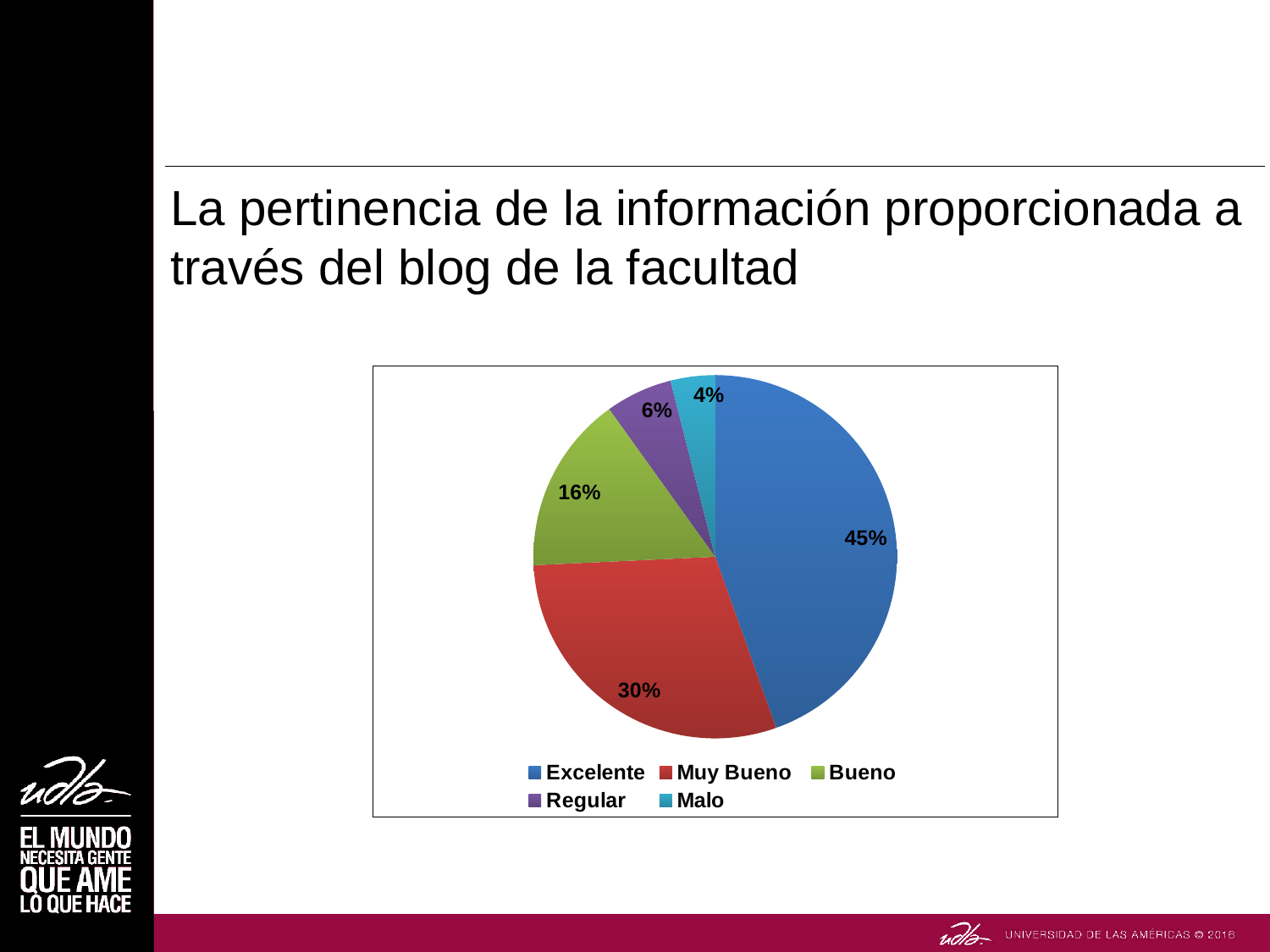
What percentage of the pie chart is labelled Excelente? 45% What percentage of the pie chart is labelled Malo? 4% How many categories does the pie chart show? 5 Which category has the smallest share of the pie chart? Malo What percentage of the pie chart is labelled Regular? 6% Which is larger, the share for Bueno or the share for Regular? Bueno What percentage of the pie chart is labelled Muy Bueno? 30% Which category has the largest share of the pie chart? Excelente What type of chart is shown on the slide? Pie chart What is the difference in percentage points between Excelente and Muy Bueno? 15 What colour is the Muy Bueno slice in the pie chart? Red What percentage of the pie chart is labelled Bueno? 16%